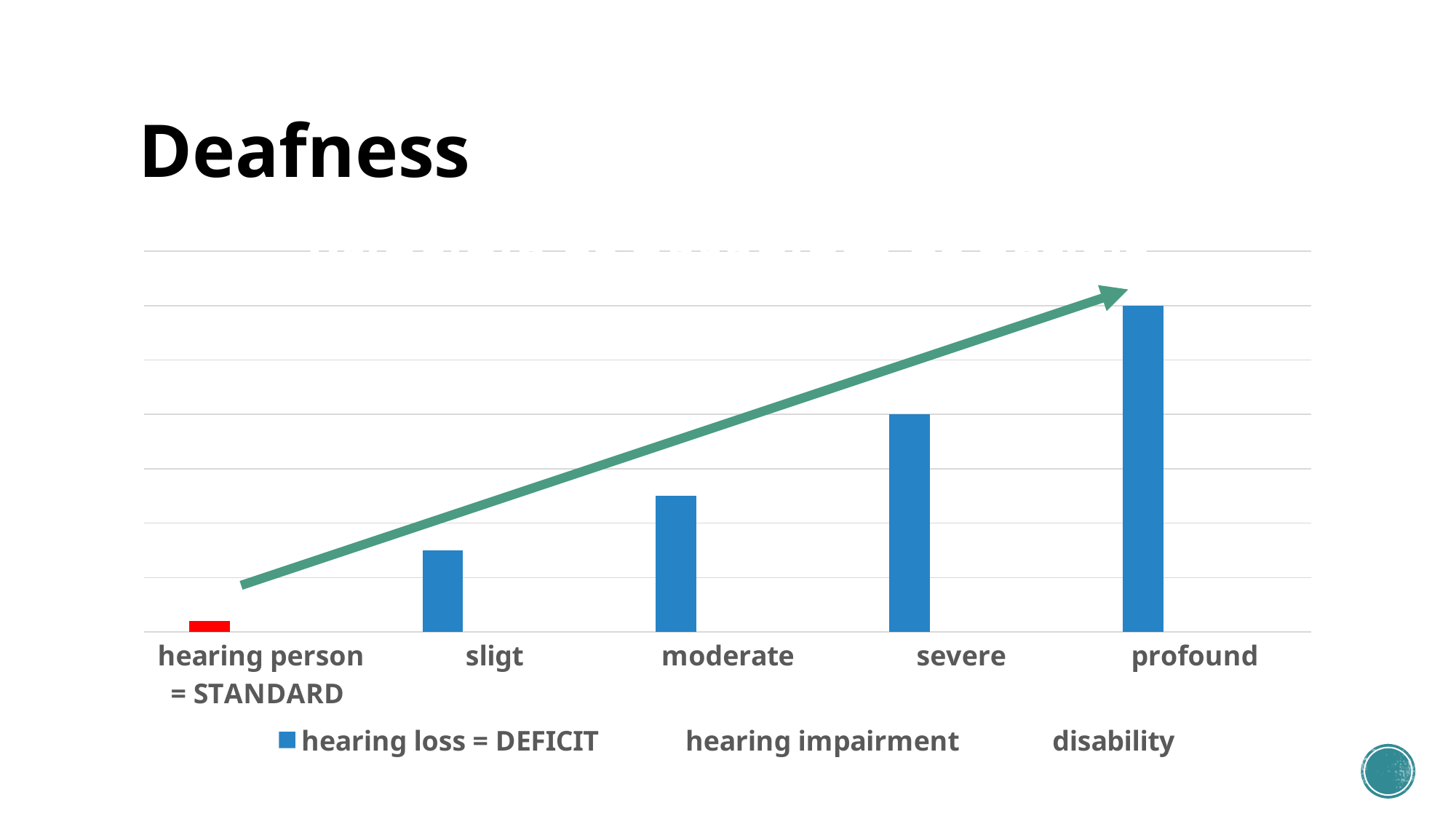
Which bar is taller, hearing person = STANDARD or sligt? sligt How many categories are shown on the x axis of the chart? 5 What kind of chart is shown on the slide? bar chart Which bar is taller, severe or moderate? severe What is the title of the slide containing the chart? Deafness Which bar is taller, sligt or profound? profound Which category has the shortest bar? hearing person = STANDARD Which category has the tallest bar? profound What colour is the bar for hearing person = STANDARD? red Do the bar heights rise or fall from left to right along the x axis? rise